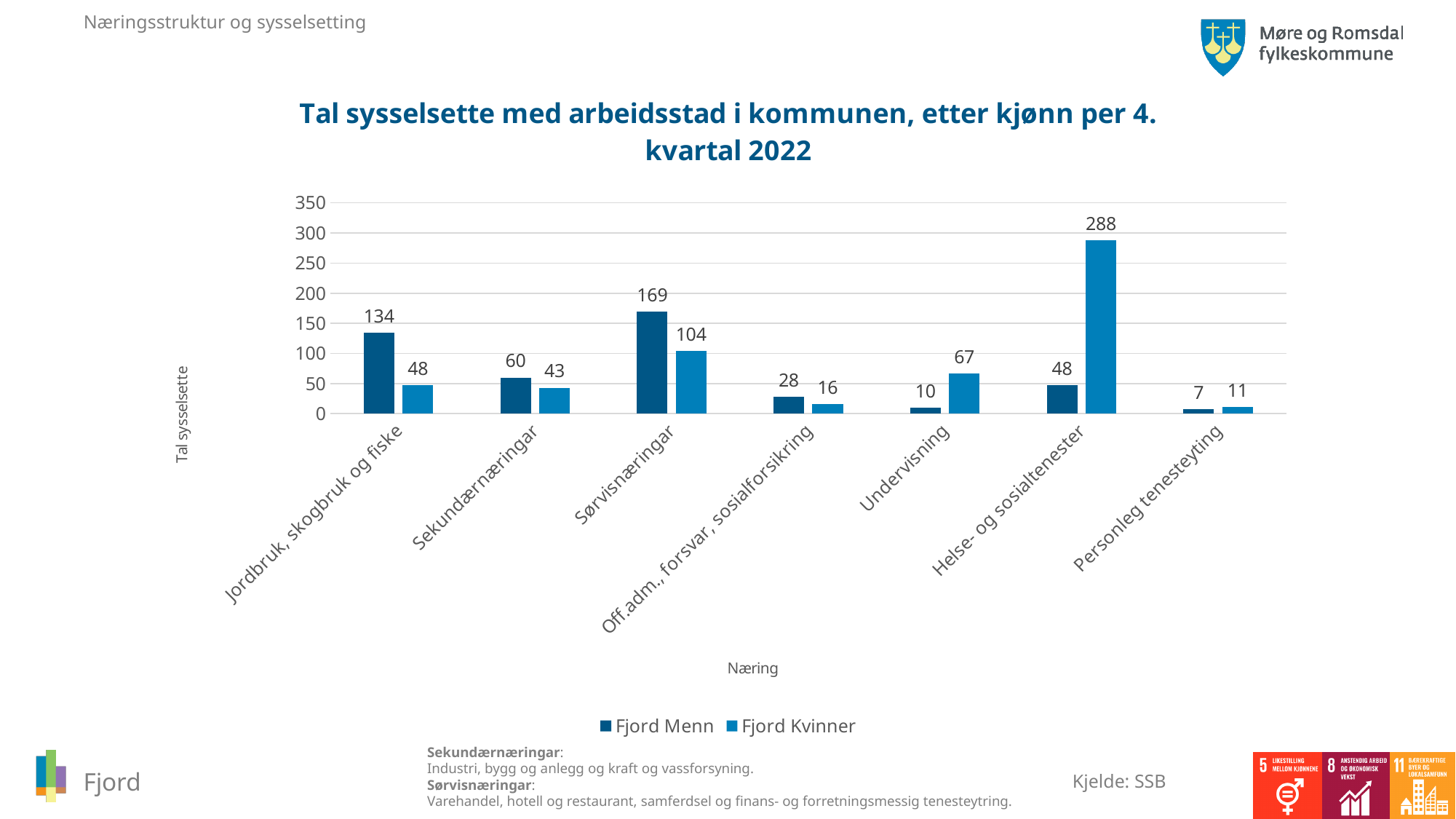
What is the value for Fjord Menn in Jordbruk, skogbruk og fiske? 134 What is the value for Fjord Kvinner in Helse- og sosialtenester? 288 How many categories are shown on the x axis? 7 What is the difference between Fjord Menn and Fjord Kvinner in Sørvisnæringar? 65 What kind of chart is shown on the slide? Bar chart Which is larger in Undervisning, Fjord Menn or Fjord Kvinner? Fjord Kvinner What is the value for Fjord Kvinner in Undervisning? 67 What is the label of the y axis? Tal sysselsette What is the total of Fjord Menn and Fjord Kvinner in Sekundærnæringar? 103 Which category has the highest value for Fjord Menn? Sørvisnæringar How many series does the legend list? 2 Which category has the lowest value for Fjord Kvinner? Personleg tenesteyting